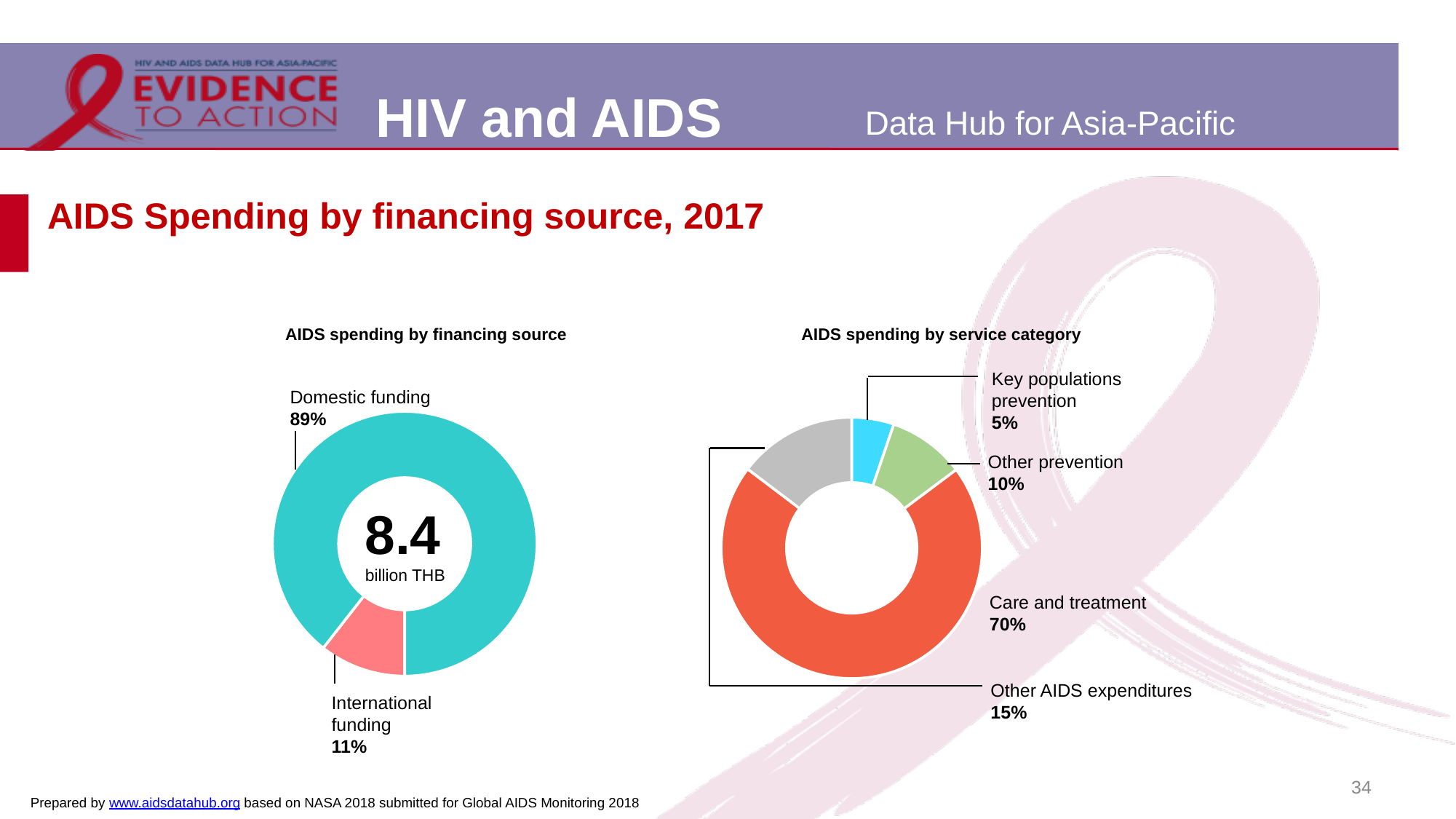
In the 'AIDS spending by service category' chart, which service category has the largest share? Care and treatment In the 'AIDS spending by financing source' chart, what is the difference in percentage points between domestic funding and international funding? 78 percentage points In the 'AIDS spending by service category' chart, what share of spending goes to key populations prevention? 5% In the 'AIDS spending by financing source' chart, what share of spending comes from domestic funding? 89% In the 'AIDS spending by financing source' chart, what share of spending comes from international funding? 11% In the 'AIDS spending by financing source' chart, what total amount is shown in the centre of the donut? 8.4 billion THB What kind of chart is used for 'AIDS spending by service category'? Donut (pie) chart In the 'AIDS spending by service category' chart, what share of spending goes to other AIDS expenditures? 15% In the 'AIDS spending by service category' chart, what share of spending goes to care and treatment? 70% In the 'AIDS spending by service category' chart, how many service categories are shown? 4 In the 'AIDS spending by financing source' chart, how many slices does the donut have? 2 In the 'AIDS spending by service category' chart, which service category has the smallest share? Key populations prevention